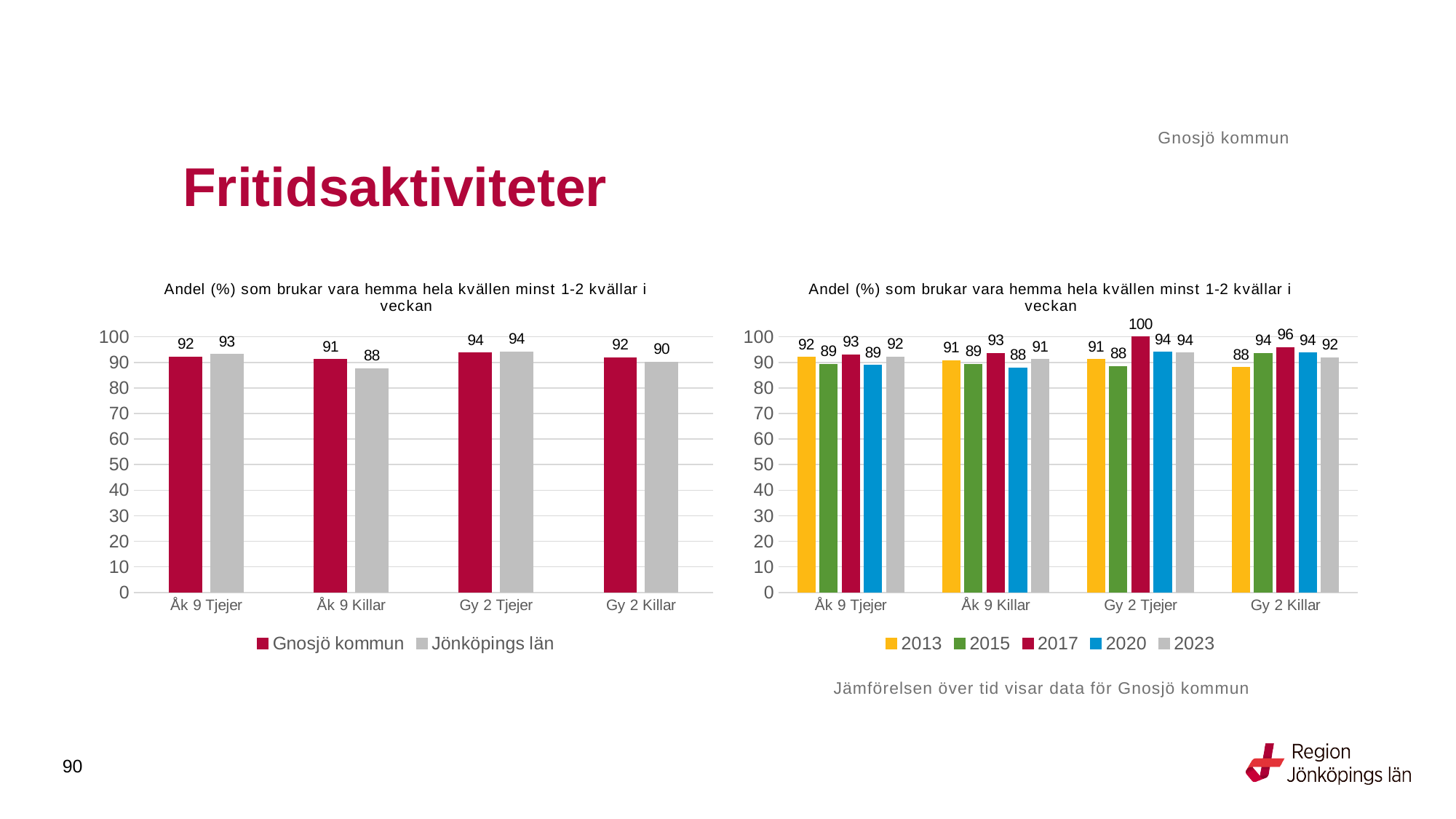
In the left chart, what is the value for Jönköpings län for Gy 2 Killar? 90 In the right chart, what is the value for 2013 for Gy 2 Killar? 88 In the right chart, how many series does the legend list? 5 In the left chart, how many series does the legend list? 2 In the right chart, which is larger for Åk 9 Tjejer: 2013 or 2015? 2013 In the right chart, which year has the highest value for Gy 2 Killar? 2017 In the left chart, what is the value for Gnosjö kommun for Åk 9 Killar? 91 In the left chart, which category has the lowest value for Jönköpings län? Åk 9 Killar In the left chart, what is the difference between Gnosjö kommun and Jönköpings län for Åk 9 Killar? 3 What kind of chart is the right chart? Bar chart In the right chart, what is the value for 2017 for Gy 2 Tjejer? 100 In the right chart, what is the difference between 2017 and 2015 for Gy 2 Tjejer? 12